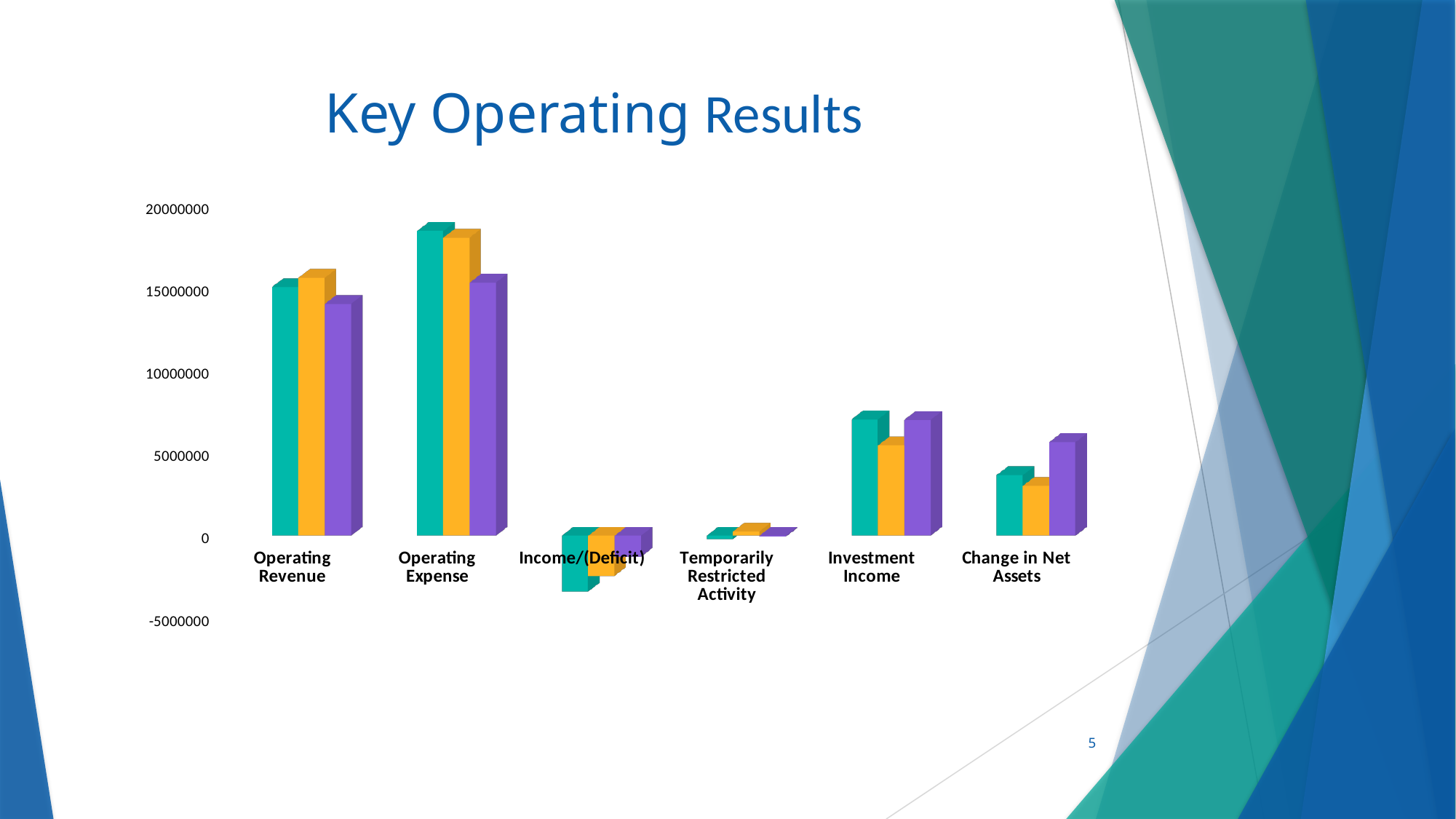
What is the title shown above the chart on the slide? Key Operating Results Is the teal bar for Change in Net Assets greater or less than 5000000? less Which is larger, the teal bar for Operating Expense or the teal bar for Operating Revenue? Operating Expense Which category has the tallest bar in the chart? Operating Expense Is the teal bar for Investment Income greater or less than 5000000? greater How many categories are shown on the x axis of the chart? 6 Which category has the lowest (most negative) bar in the chart? Income/(Deficit) Is the purple bar for Operating Revenue greater or less than 15000000? less Which is larger, the purple bar for Investment Income or the purple bar for Change in Net Assets? Investment Income What kind of chart is shown on the slide? bar chart